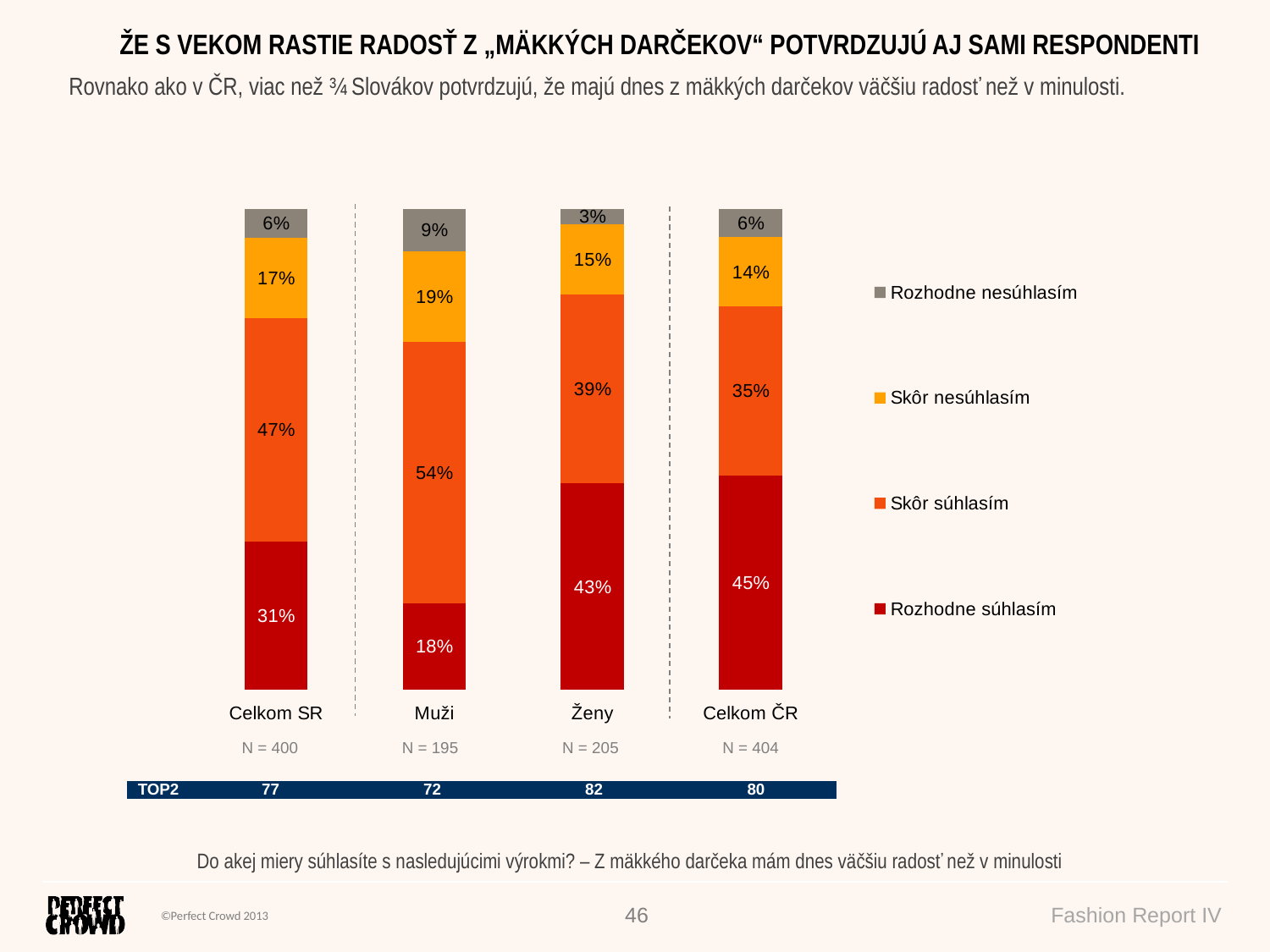
How many categories are shown on the x axis of the chart? 4 Which category has the lowest "Rozhodne nesúhlasím" share? Ženy How many series does the legend list? 4 What is the "Skôr súhlasím" value for Ženy? 39% Which category has the highest "Rozhodne súhlasím" share? Celkom ČR What kind of chart is shown on the slide? Stacked bar chart What is the difference between the "Skôr súhlasím" values for Muži and Celkom SR? 7% What is the "Rozhodne nesúhlasím" value for Celkom ČR? 6% Which is larger: the "Skôr nesúhlasím" value for Muži or for Celkom ČR? Muži What is the sample size (N) shown for Muži? N = 195 What is the combined share of "Rozhodne súhlasím" and "Skôr súhlasím" for Ženy? 82% What percentage of Muži answered "Rozhodne súhlasím"? 18%